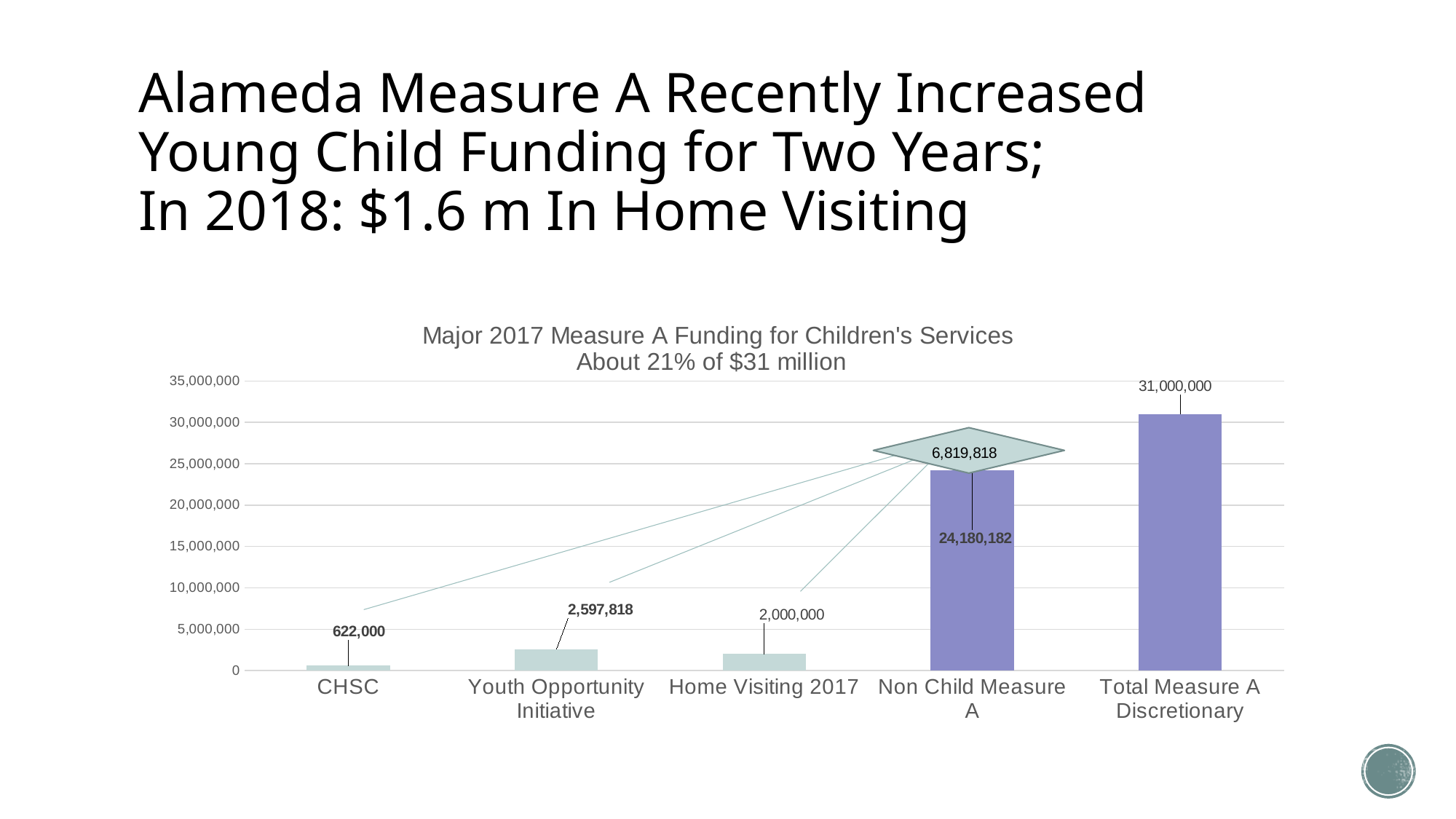
What is the value for CHSC? 622,000 What is the difference between Total Measure A Discretionary and Non Child Measure A? 6,819,818 What is the difference between Youth Opportunity Initiative and Home Visiting 2017? 597,818 Which is larger, Youth Opportunity Initiative or Home Visiting 2017? Youth Opportunity Initiative Which category has the lowest value? CHSC What is the title of the chart? Major 2017 Measure A Funding for Children's Services About 21% of $31 million How many categories are shown on the x axis? 5 Which category has the highest value? Total Measure A Discretionary What kind of chart is shown on the slide? Bar chart What is the value for Non Child Measure A? 24,180,182 What is the value for Youth Opportunity Initiative? 2,597,818 What is the value for Home Visiting 2017? 2,000,000